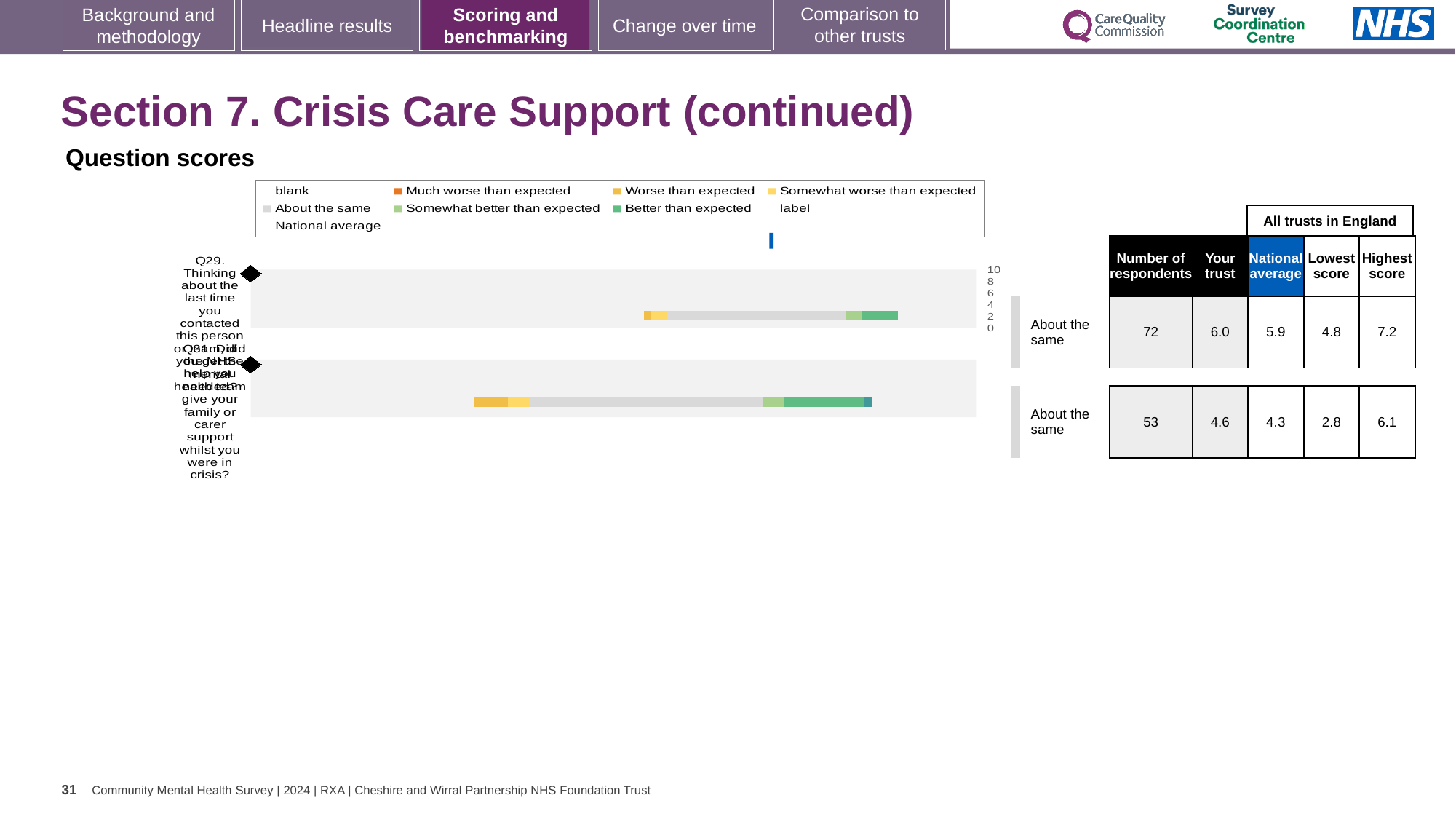
What kind of chart is used to show the question scores on this slide? bar chart What is the 'Your trust' score for Q31 (Did the NHS mental health team give your family or carer support whilst you were in crisis)? 4.6 What is the highest value shown on the chart's score axis? 10 What is the highest score among all trusts in England for Q29? 7.2 What is the difference between the 'Your trust' score and the national average for Q31? 0.3 Which question has the higher 'Your trust' score, Q29 or Q31? Q29 What benchmark category label is shown next to both Q29 and Q31 in the chart? About the same How many respondents answered Q31? 53 What is the national average score for Q29? 5.9 What is the 'Your trust' score for Q29 (Thinking about the last time you contacted this person or team, did you get the help you needed)? 6.0 What is the lowest score among all trusts in England for Q31? 2.8 How many questions (categories) are plotted in the question scores chart? 2